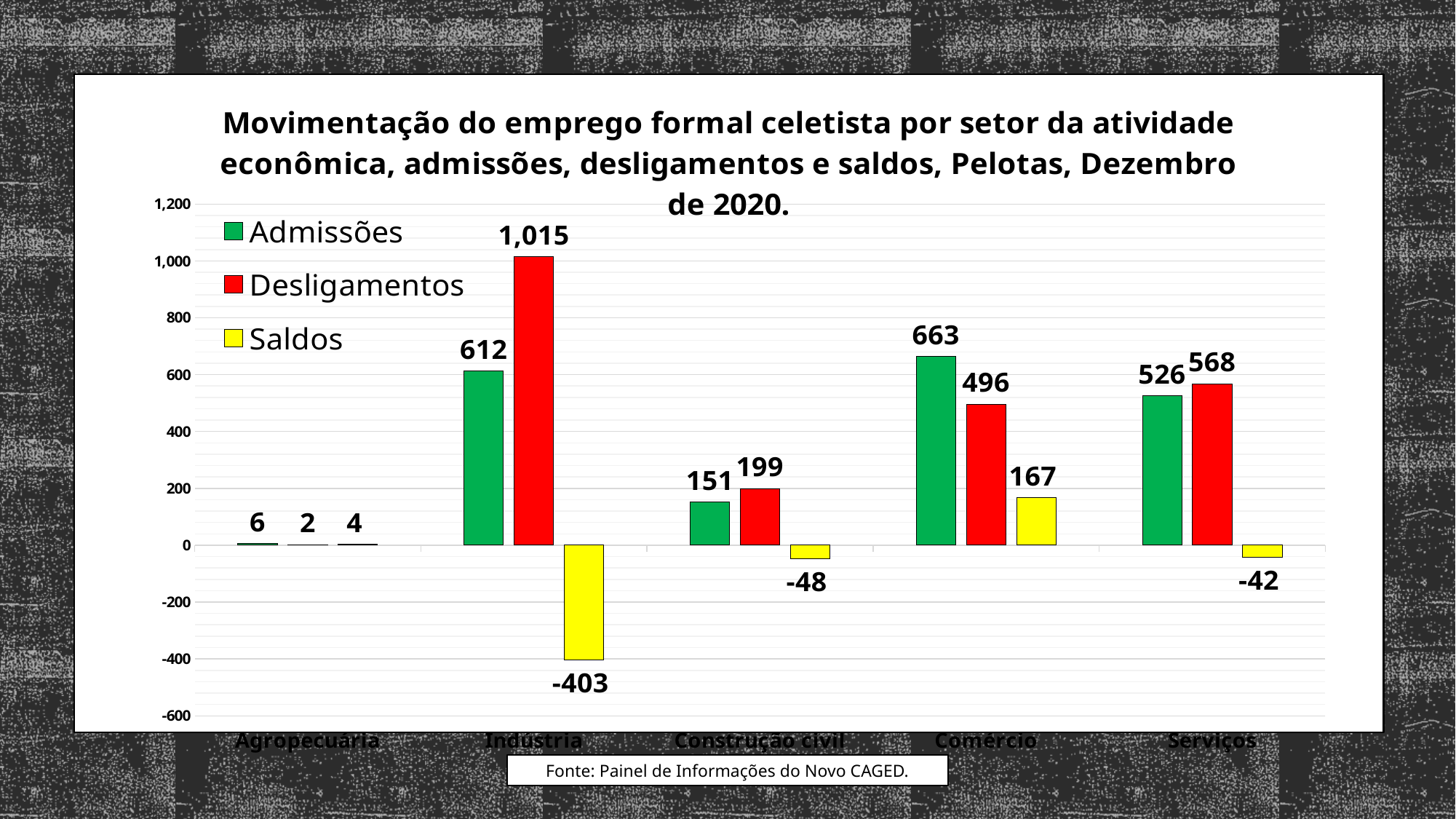
Which is larger for Construção civil, Admissões or Desligamentos? Desligamentos What is the difference between Desligamentos and Admissões for Indústria? 403 What kind of chart is shown on the slide? Bar chart What is the Desligamentos value for Indústria? 1,015 Which sector has the highest Admissões value? Comércio What is the Saldos value for Comércio? 167 What is the Admissões value for Serviços? 526 Which sector has the lowest Saldos value? Indústria What colour represents the Saldos series? Yellow How many sectors are shown on the x axis? 5 Is the Desligamentos value for Comércio greater or less than 400? greater How many series does the legend list? 3